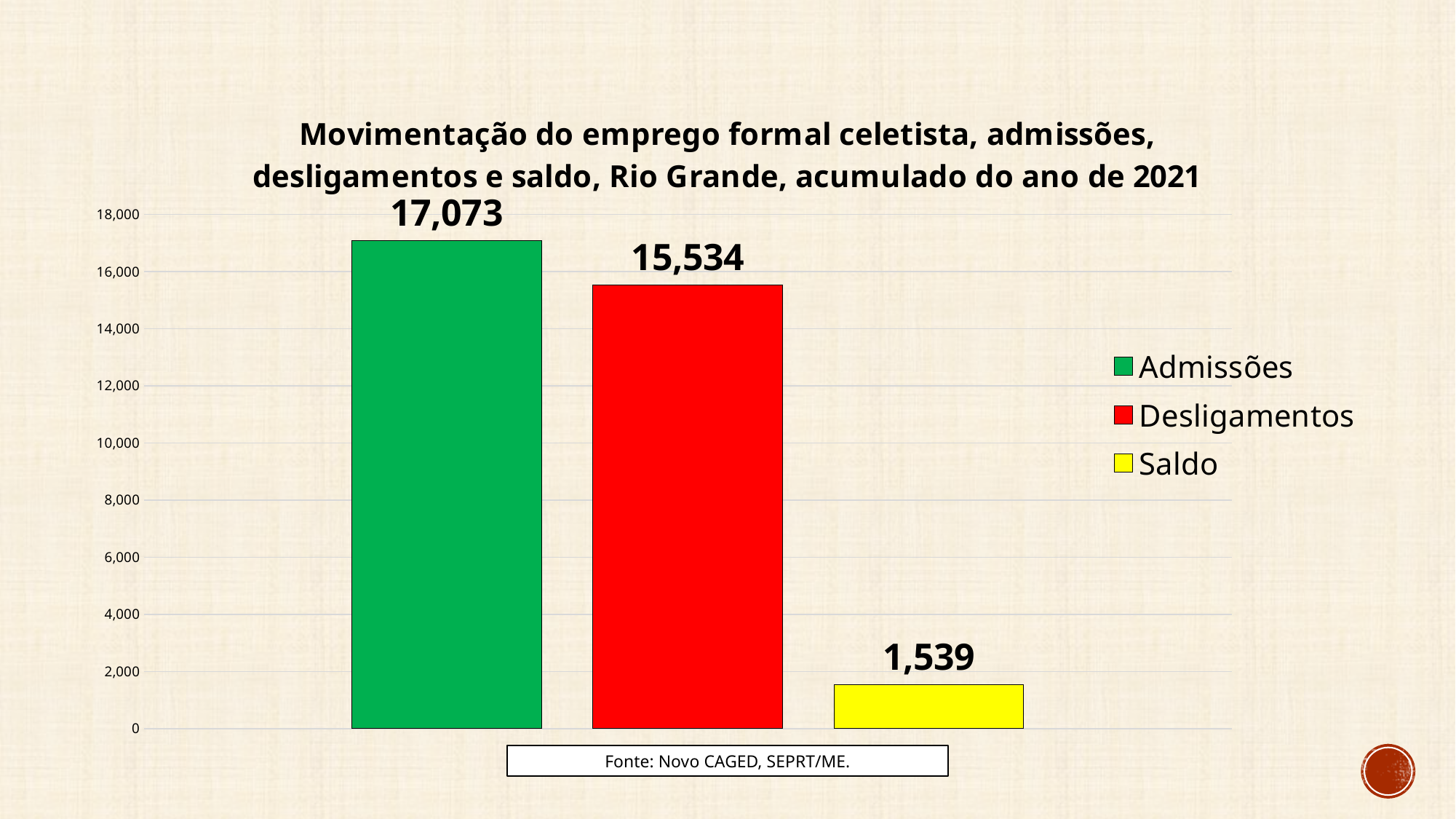
Is the value for Desligamentos greater or less than 16,000? less What kind of chart is shown? bar chart What is the difference between Admissões and Desligamentos? 1,539 What is the value for Saldo? 1,539 Which is larger, Desligamentos or Saldo? Desligamentos What source is cited below the chart? Novo CAGED, SEPRT/ME. What colour is the bar for Saldo? yellow Which series has the highest value? Admissões How many series does the legend list? 3 What is the value for Desligamentos? 15,534 Which series has the lowest value? Saldo What is the value for Admissões? 17,073